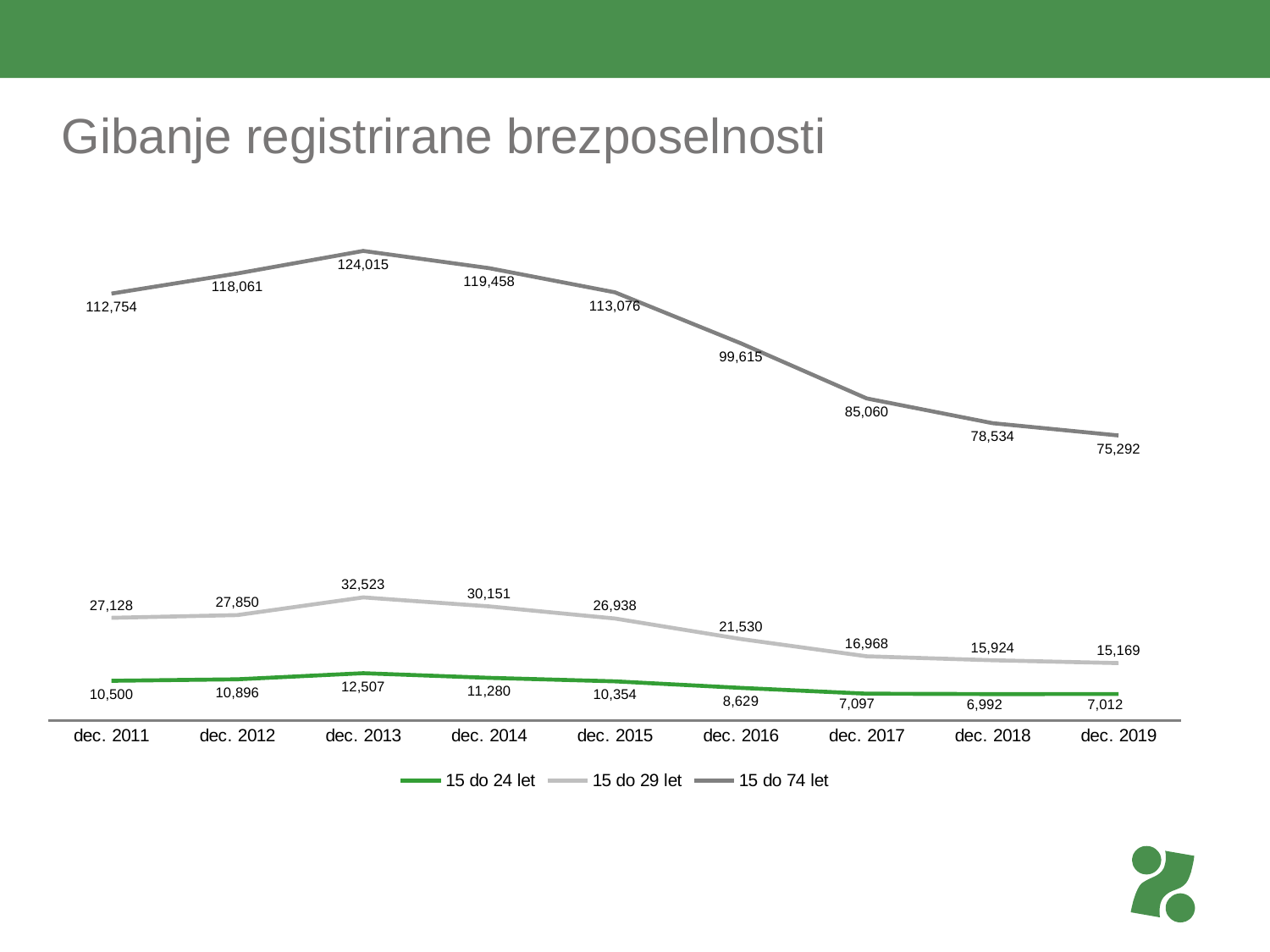
What is the difference between the 15 do 74 let values in dec. 2011 and dec. 2019? 37,462 In which period does the 15 do 74 let series reach its highest value? dec. 2013 How many time points are shown on the x axis? 9 In which period does the 15 do 24 let series reach its lowest value? dec. 2018 For the 15 do 29 let series, which is larger: the value in dec. 2014 or in dec. 2015? dec. 2014 What kind of chart is shown on the slide? line chart By how much did the 15 do 29 let series fall from dec. 2013 to dec. 2019? 17,354 Does the 15 do 74 let series rise or fall from dec. 2013 to dec. 2019? fall What is the value for the 15 do 29 let series in dec. 2016? 21,530 What is the value for the 15 do 24 let series in dec. 2019? 7,012 How many series does the legend list? 3 What is the value for the 15 do 74 let series in dec. 2013? 124,015